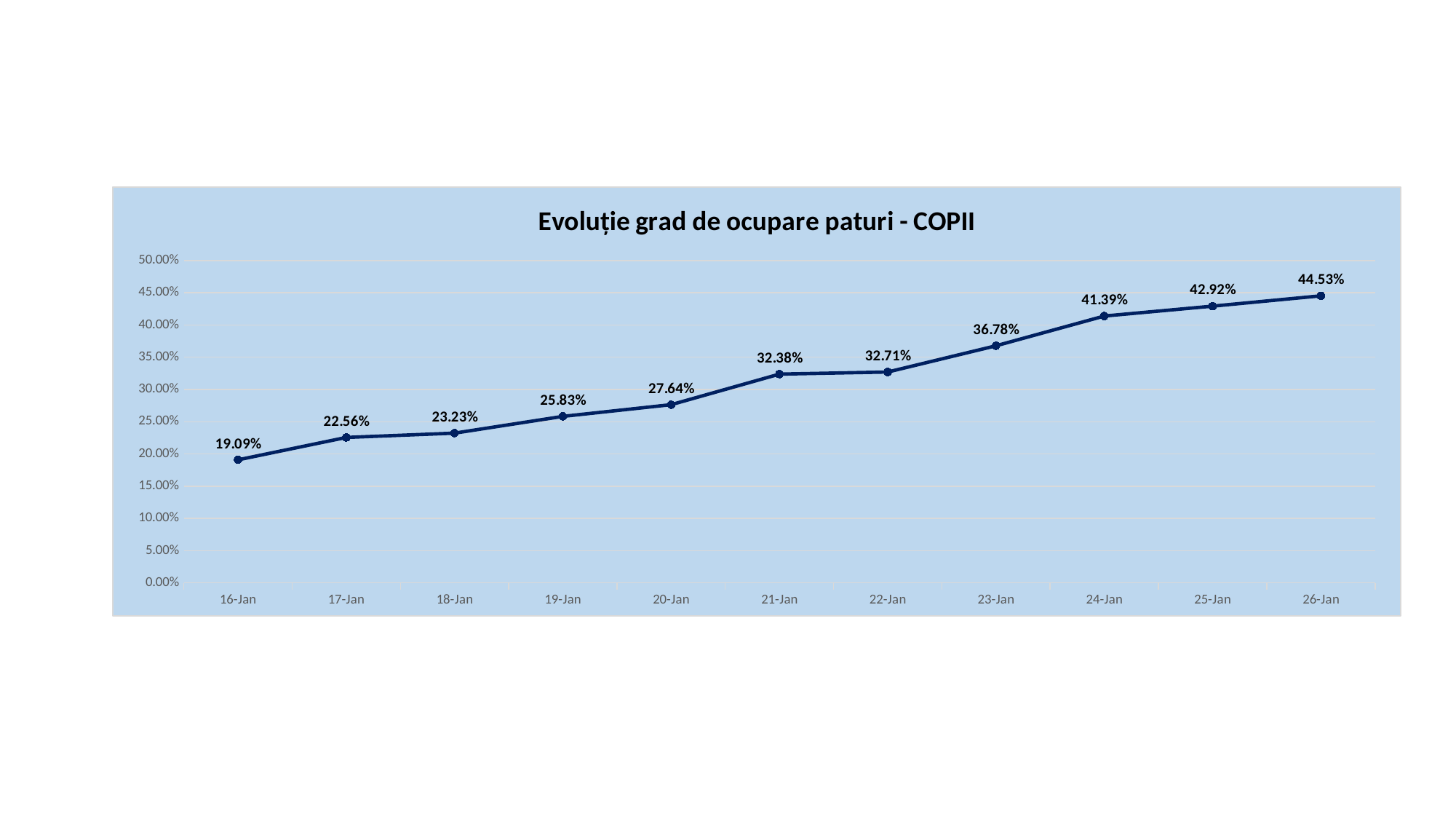
What is the difference between the values for 26-Jan and 16-Jan? 25.44% What is the difference between the values for 23-Jan and 22-Jan? 4.07% What is the value for 16-Jan? 19.09% Which is larger, the value for 19-Jan or the value for 20-Jan? 20-Jan What is the value for 22-Jan? 32.71% Is the value for 25-Jan greater or less than 40.00%? greater What kind of chart is this? line chart What is the value for 24-Jan? 41.39% Do the values rise or fall from 16-Jan to 26-Jan? rise Which date has the highest value? 26-Jan How many dates are plotted on the x axis? 11 Which date has the lowest value? 16-Jan